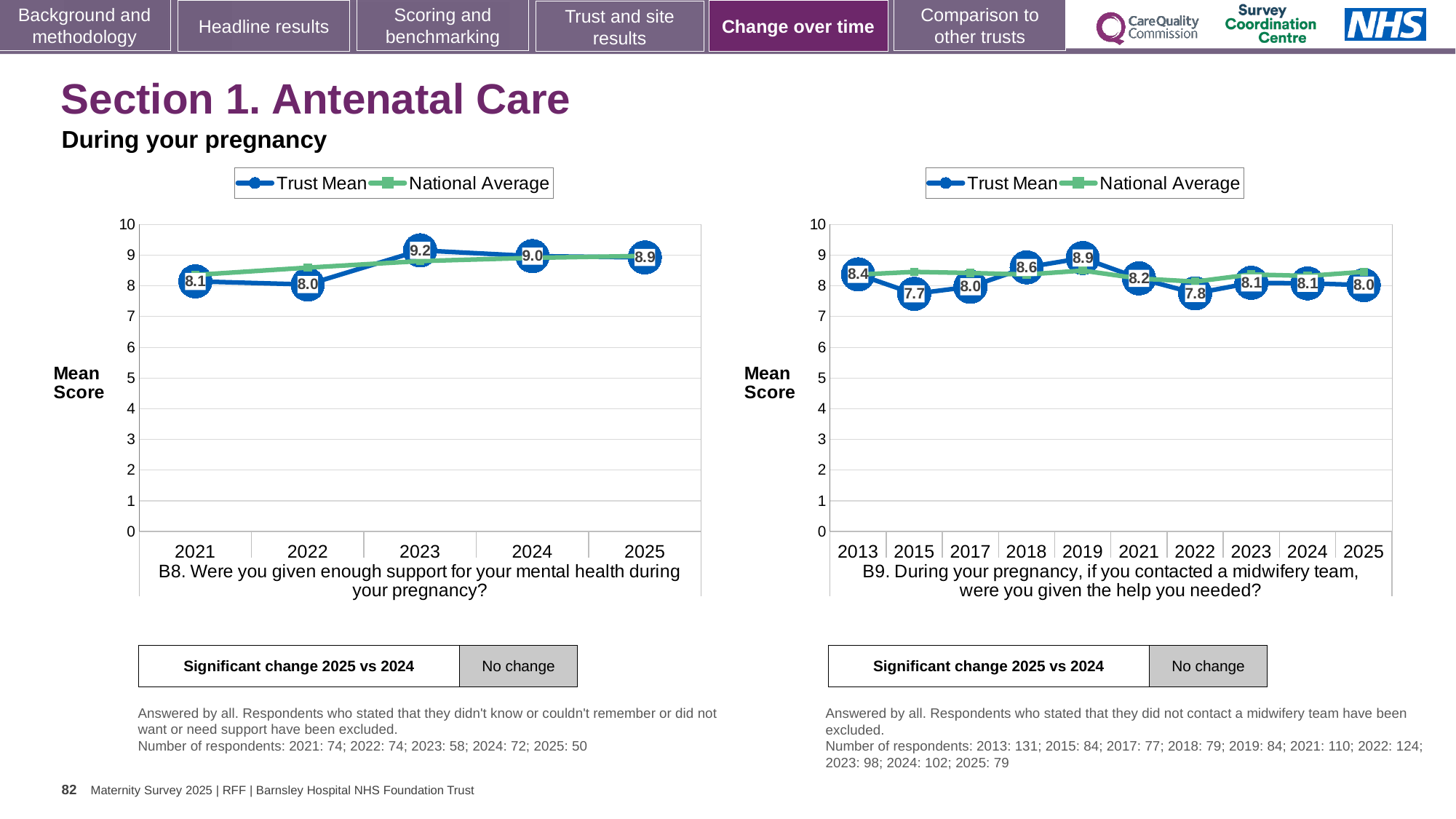
In the B8 chart (left), what is the Trust Mean for 2023? 9.2 In the B8 chart (left), what is the difference between the Trust Mean for 2023 and 2022? 1.2 In the B8 chart (left), how many years are plotted on the x axis? 5 In the B9 chart (right), what is the Trust Mean for 2019? 8.9 In the B9 chart (right), how many series does the legend list? 2 In the B9 chart (right), which year has the highest Trust Mean? 2019 In the B9 chart (right), which year has the lowest Trust Mean? 2015 What type of chart is the B9 chart (right)? Line chart In the B8 chart (left), which year has the highest Trust Mean? 2023 In the B8 chart (left), which year has the lowest Trust Mean? 2022 In the B9 chart (right), is the Trust Mean for 2018 or 2022 larger? 2018 In the B8 chart (left), what is the Trust Mean for 2021? 8.1